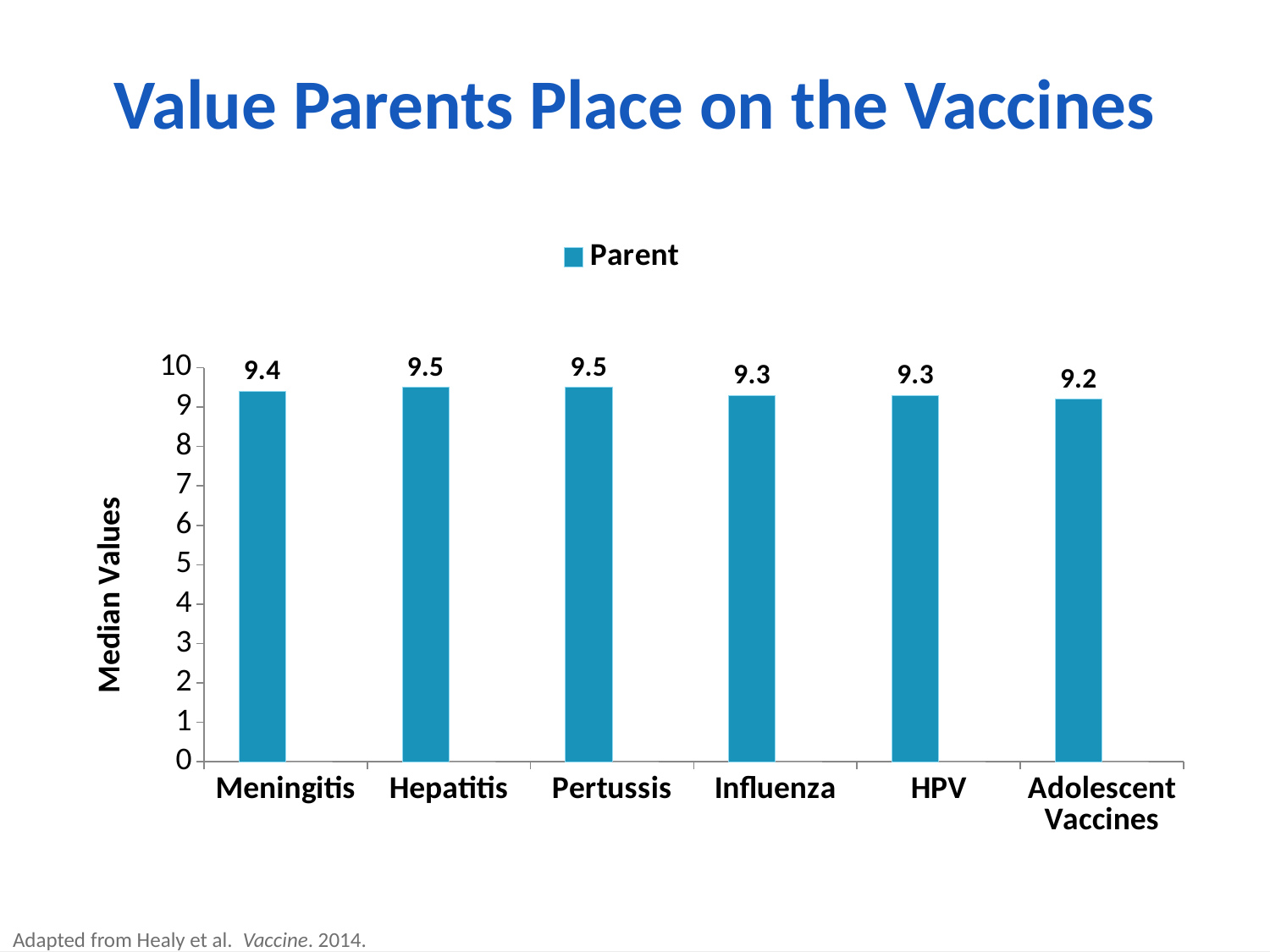
How many vaccine categories are shown on the x axis? 6 Is the median value for HPV greater or less than 9? greater Which vaccine has the lowest median value? Adolescent Vaccines What is the median value for Hepatitis? 9.5 What is the median value for Influenza? 9.3 What kind of chart is shown on the slide? bar chart What is the label of the y axis? Median Values What is the median value for Adolescent Vaccines? 9.2 Which has a higher median value, Pertussis or Adolescent Vaccines? Pertussis What is the median value for Meningitis? 9.4 How many series does the legend list? 1 What is the difference between the median values for Hepatitis and Adolescent Vaccines? 0.3